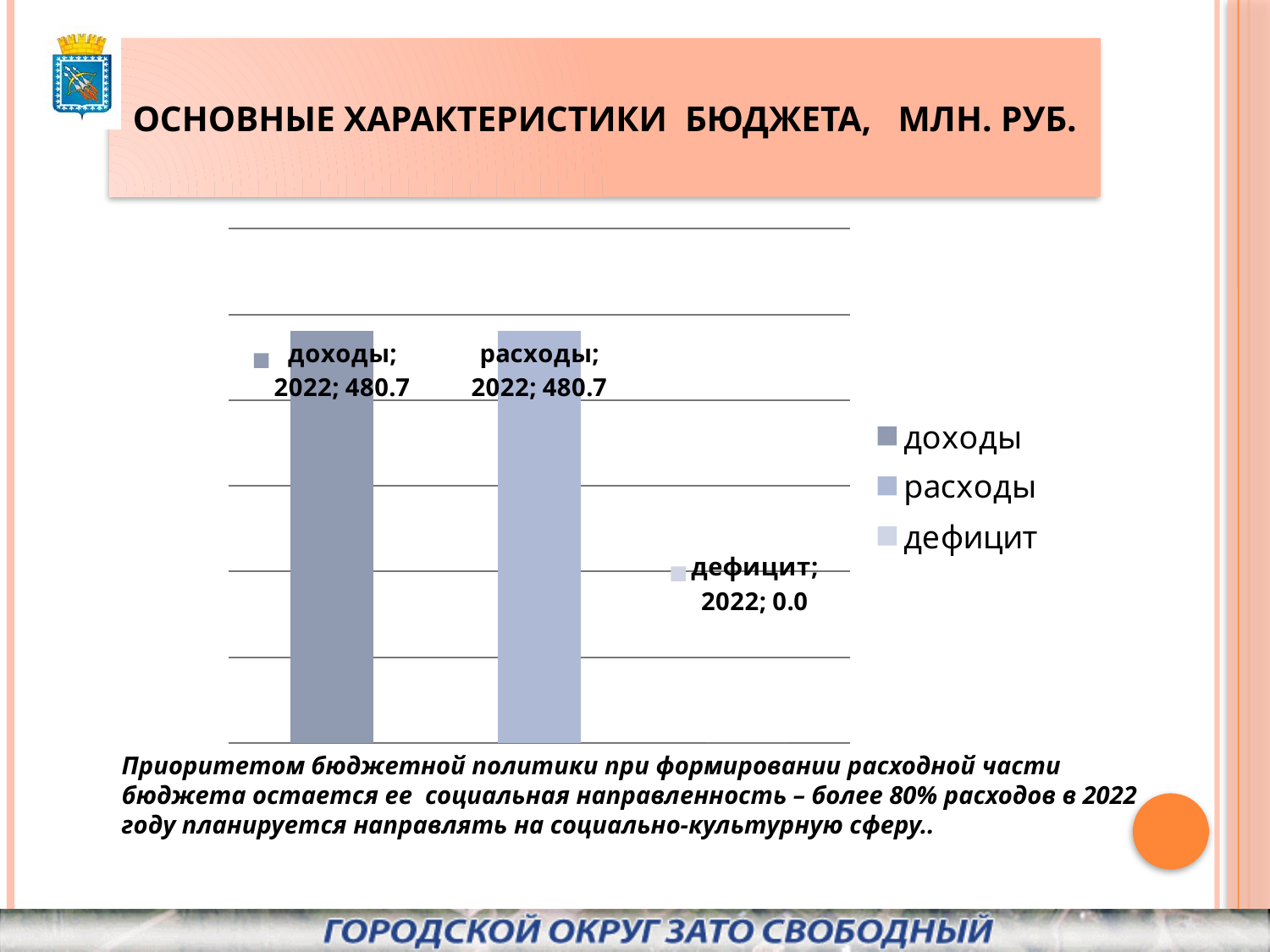
How many series does the legend list? 3 What kind of chart is shown on the slide? bar chart What is the value for доходы in 2022? 480.7 How many bars are plotted on the chart? 2 What is the difference between доходы and дефицит in 2022? 480.7 What is the difference between доходы and расходы in 2022? 0.0 Which is larger, доходы or дефицит? доходы Which is larger, расходы or дефицит? расходы What is the value for расходы in 2022? 480.7 Which series has the lowest value on the chart? дефицит What unit is stated in the slide title for the budget figures? млн. руб. What is the value for дефицит in 2022? 0.0